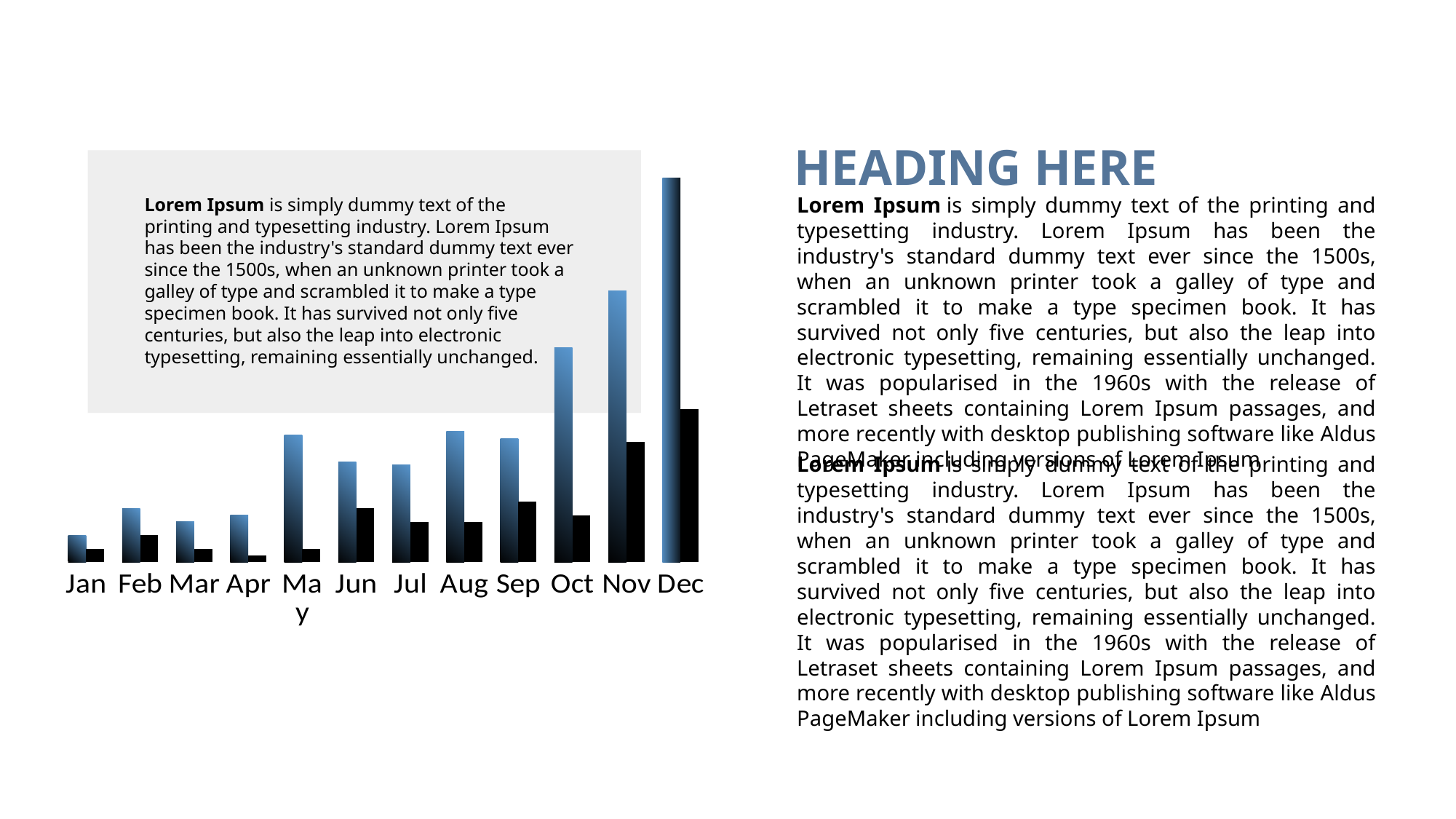
Which month has the shortest black bar? Apr Is the black bar for Sep taller or shorter than the black bar for Aug? taller Is the blue bar for Nov taller or shorter than the blue bar for Oct? taller Which month has the shortest blue bar? Jan Does the chart display a legend? No What is the first category label on the x axis of the chart? Jan Which month has the tallest blue bar? Dec Do the blue bars generally rise or fall from Jan to Dec? rise How many categories are shown on the x axis of the chart? 12 Which month has the tallest black bar? Dec What kind of chart is shown on the slide? bar chart Is the blue bar for May taller or shorter than the blue bar for Jun? taller